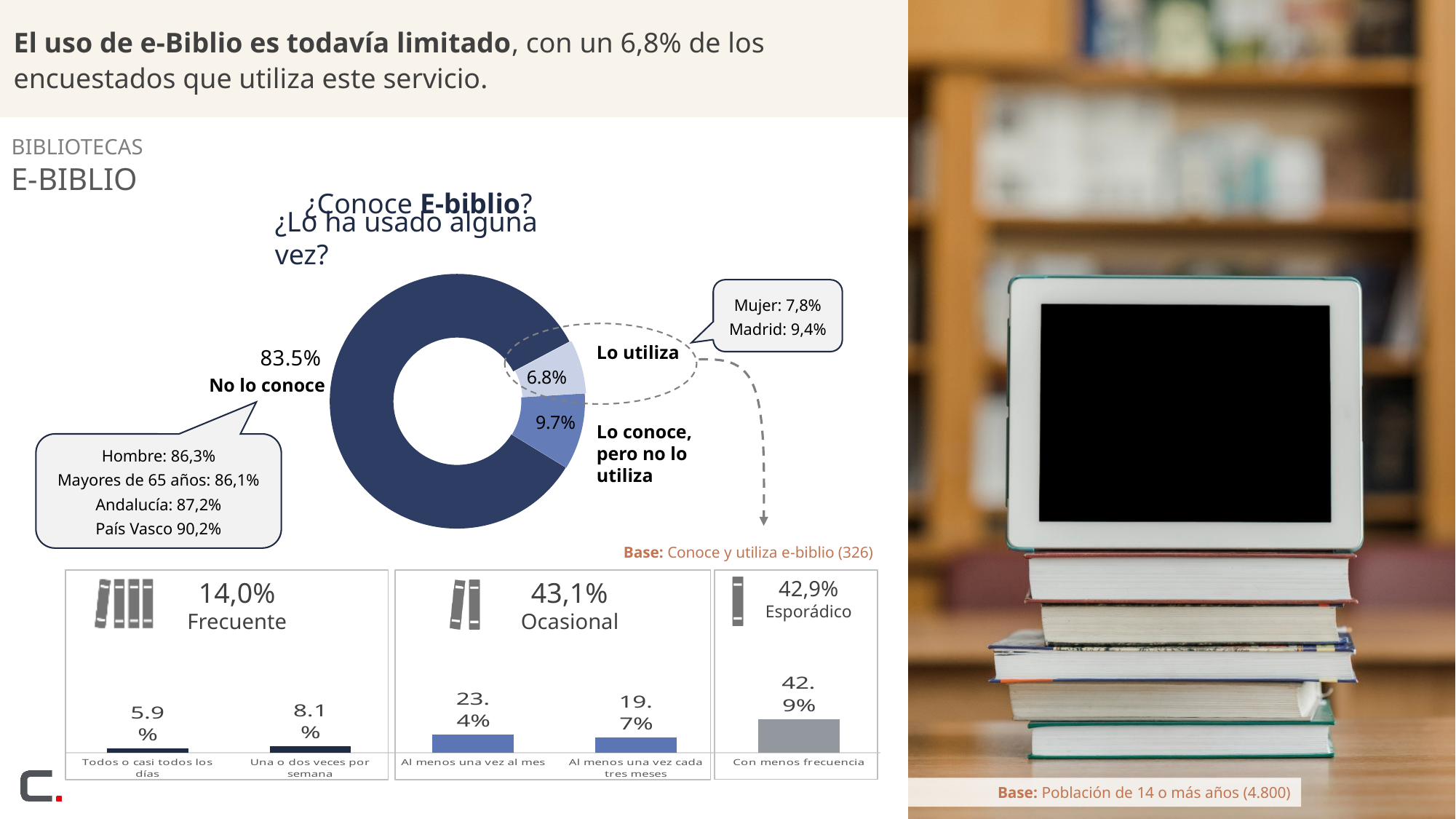
In the bar chart at the bottom, which category has the lowest value? Todos o casi todos los días In the donut chart, what share of respondents does 'No lo conoce' represent? 83.5% How many slices does the donut chart have? 3 What type of chart is the one at the bottom of the slide showing frequency of use? Bar chart In the donut chart, which category has the largest slice? No lo conoce In the bar chart at the bottom, what is the value for 'Al menos una vez al mes'? 23.4% In the bar chart at the bottom, what is the value for 'Con menos frecuencia'? 42.9% In the donut chart, what is the value for 'Lo conoce, pero no lo utiliza'? 9.7% In the donut chart, what is the difference between 'Lo conoce, pero no lo utiliza' and 'Lo utiliza'? 2.9% In the bar chart at the bottom, which is larger: 'Al menos una vez al mes' or 'Al menos una vez cada tres meses'? Al menos una vez al mes In the donut chart, what is the value for 'Lo utiliza'? 6.8% In the donut chart, which category has the smallest slice? Lo utiliza